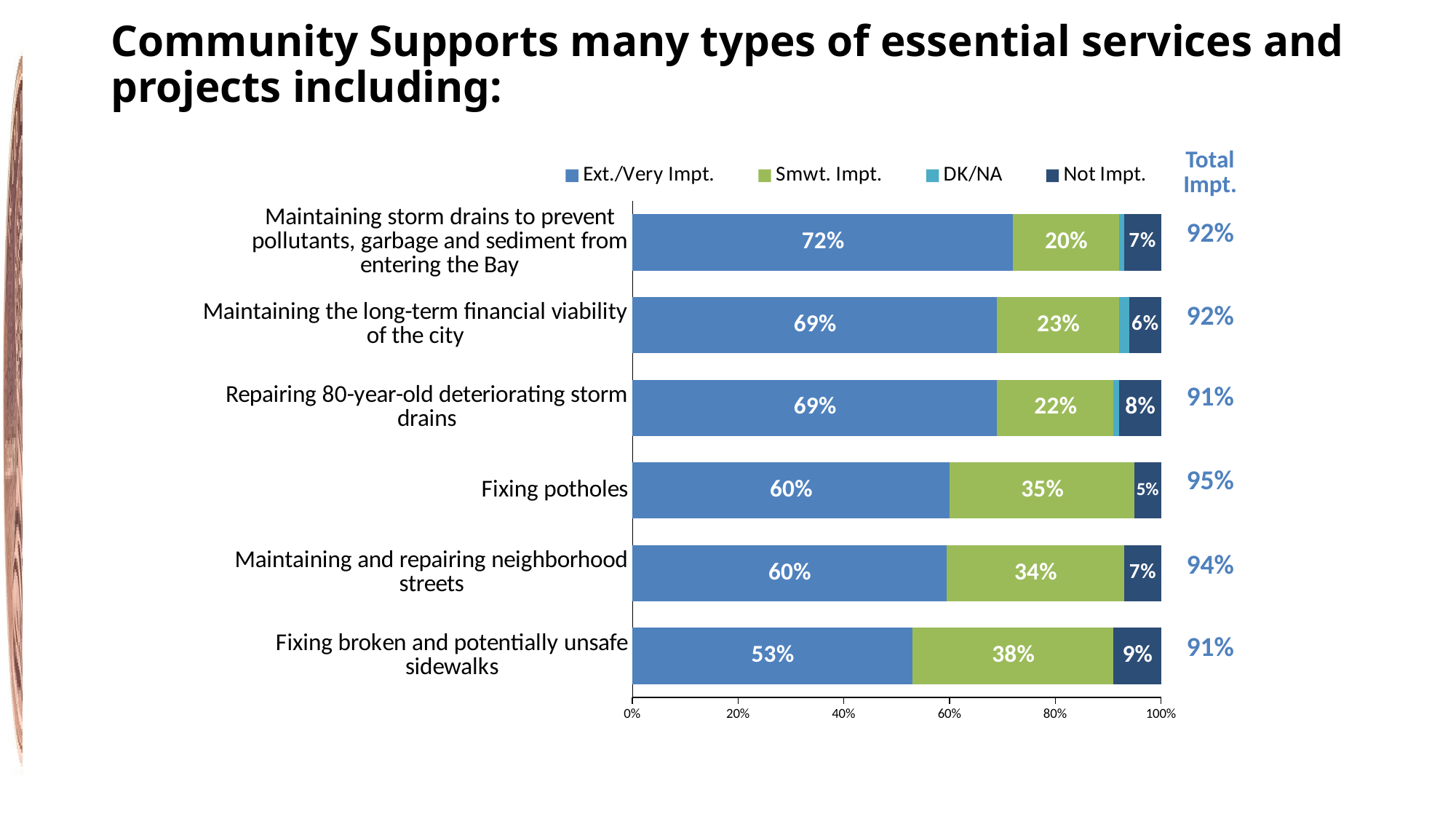
Which item has the highest Ext./Very Impt. percentage? Maintaining storm drains to prevent pollutants, garbage and sediment from entering the Bay What is the Smwt. Impt. value for "Fixing broken and potentially unsafe sidewalks"? 38% What is the Not Impt. value for "Repairing 80-year-old deteriorating storm drains"? 8% Which has a larger Smwt. Impt. share: "Fixing broken and potentially unsafe sidewalks" or "Maintaining and repairing neighborhood streets"? Fixing broken and potentially unsafe sidewalks How many service or project items are shown in the chart? 6 How many series does the legend list? 4 What is the Total Impt. figure shown for "Fixing potholes"? 95% Which item has the lowest Ext./Very Impt. percentage? Fixing broken and potentially unsafe sidewalks What kind of chart is shown on the slide? Stacked bar chart Is the Ext./Very Impt. value for "Fixing potholes" greater or less than 40%? greater What is the difference in Ext./Very Impt. percentage between "Maintaining storm drains to prevent pollutants, garbage and sediment from entering the Bay" and "Fixing broken and potentially unsafe sidewalks"? 19 percentage points What percentage rated "Fixing potholes" as Ext./Very Impt.? 60%